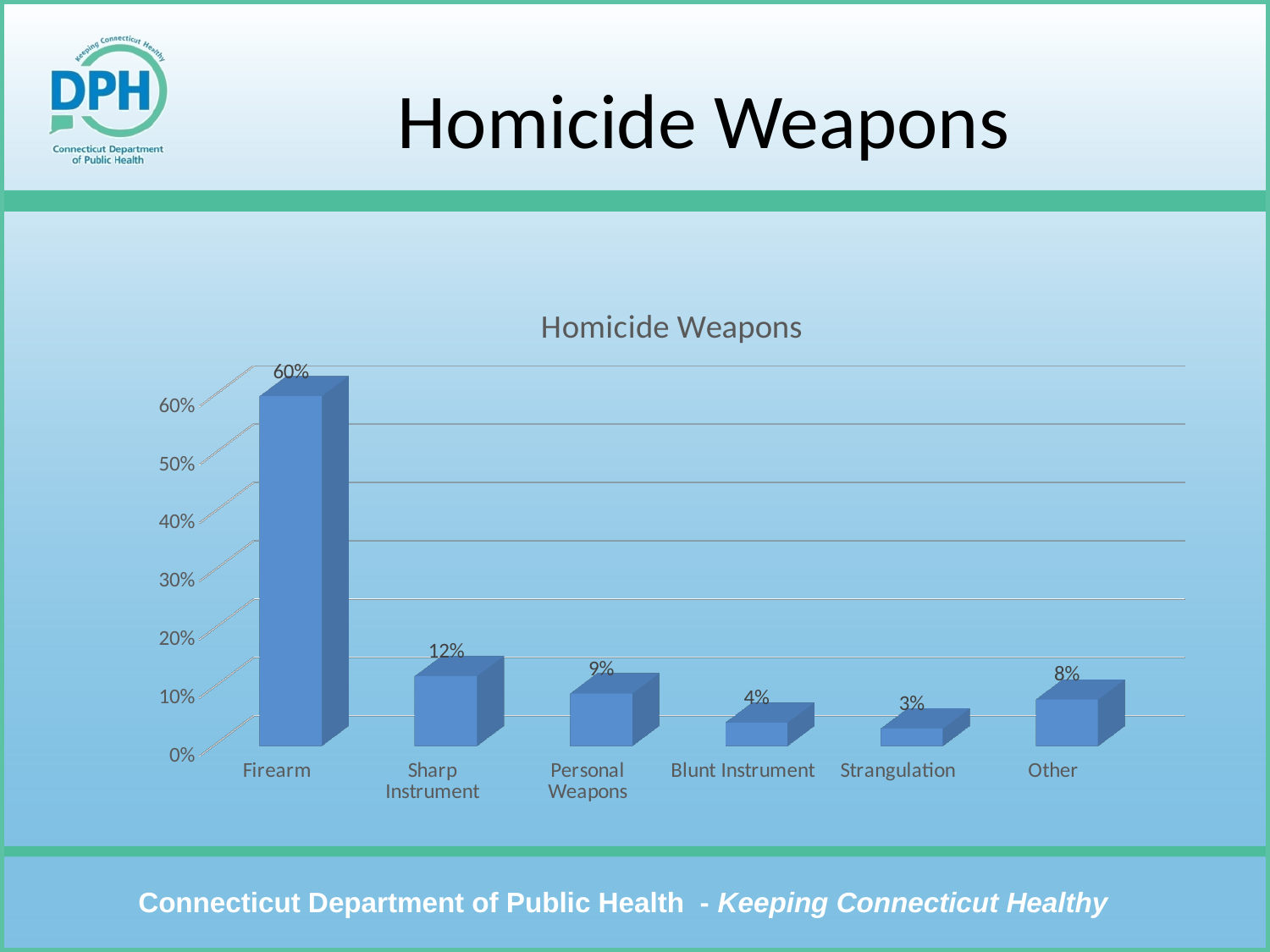
What kind of chart is shown? Bar chart Which category has the lowest value? Strangulation What is the value for Sharp Instrument? 12% How many categories are shown on the x axis? 6 Which is larger, the value for Other or the value for Blunt Instrument? Other What is the difference between the values for Personal Weapons and Blunt Instrument? 5% What is the value for Other? 8% What is the value for Strangulation? 3% What is the title of the chart? Homicide Weapons What is the difference between the values for Firearm and Sharp Instrument? 48% What is the value for Firearm? 60% Which category has the highest value? Firearm